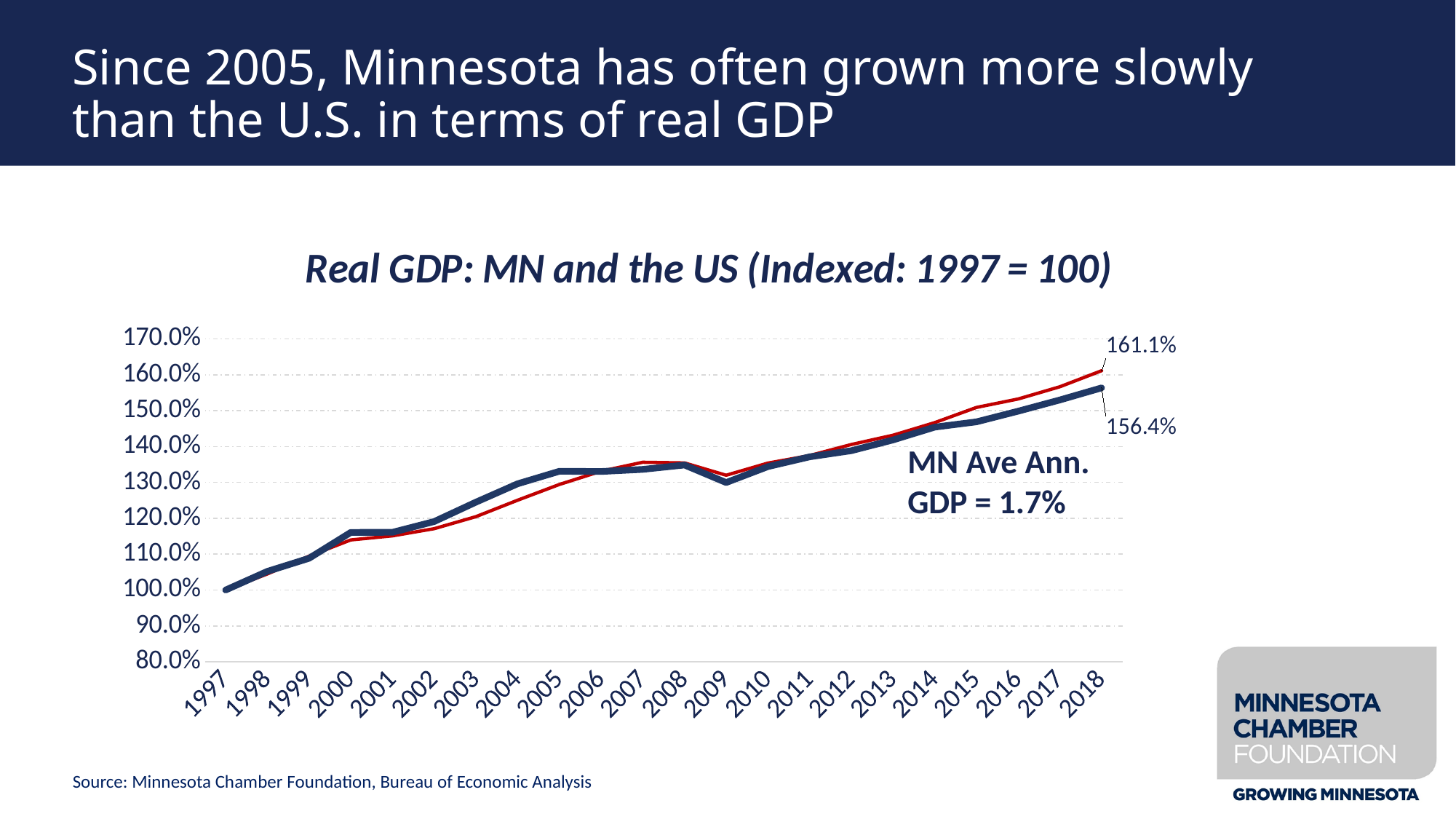
What is the indexed value of both lines in 1997? 100.0% Is the value of the dark blue Minnesota line in 2000 greater or less than 110.0%? greater What is the labelled 2018 value of the thick dark blue line (Minnesota)? 156.4% According to the annotation on the chart, what is Minnesota's average annual GDP growth? 1.7% What is the labelled 2018 value of the red line (the US)? 161.1% What is the title of the chart? Real GDP: MN and the US (Indexed: 1997 = 100) Is the value of the red US line in 2012 greater or less than 150.0%? less In 2018, which line is higher: the red US line or the dark blue Minnesota line? The red US line What is the difference between the two labelled 2018 values, 161.1% and 156.4%? 4.7 percentage points What kind of chart is shown on the slide? Line chart How many years are shown along the x axis of the chart? 22 Do the lines generally rise or fall from 1997 to 2018? Rise